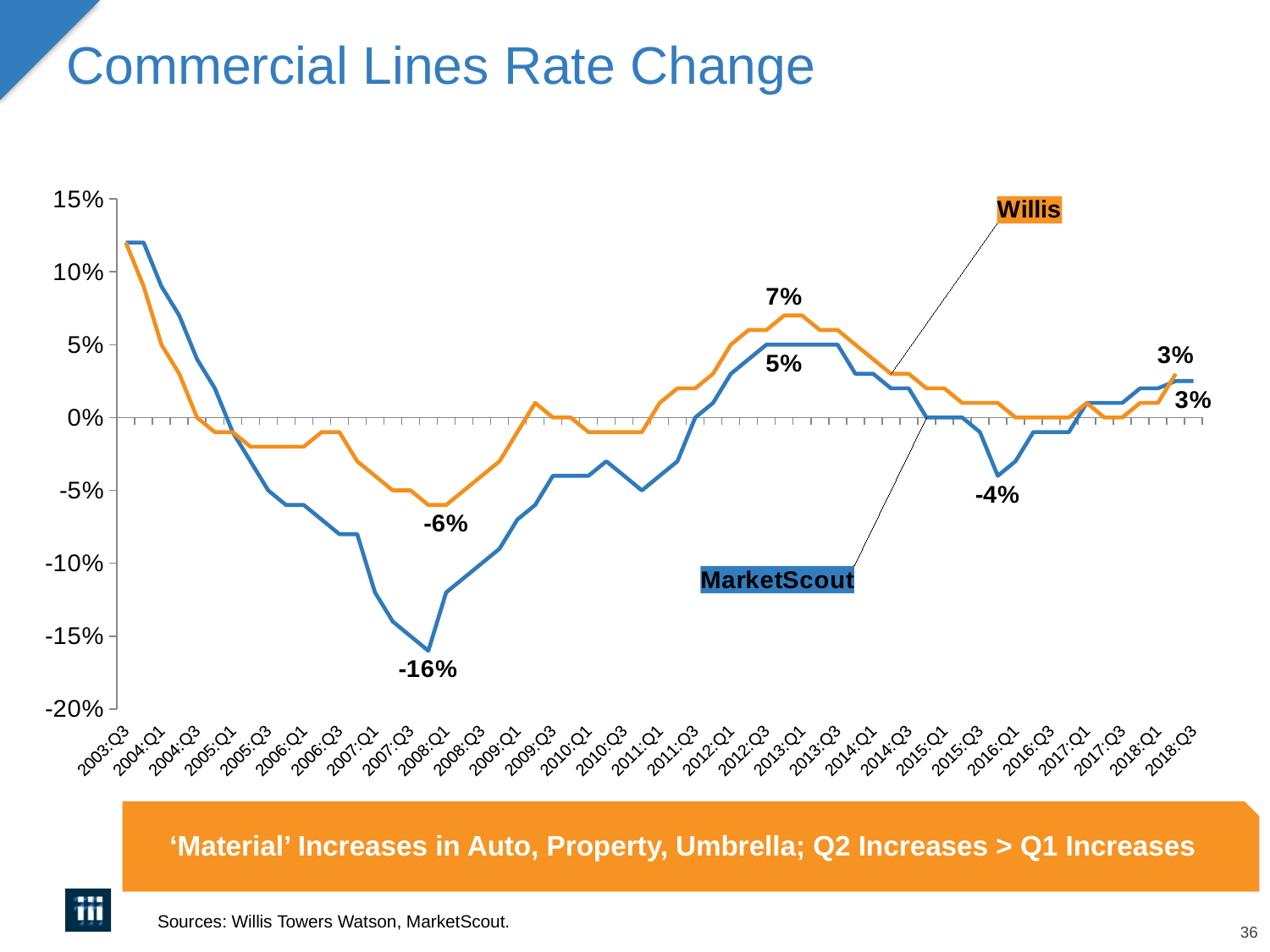
What colour is the Willis line on the chart? orange What is the lowest labelled value of the MarketScout series? -16% Is the value for MarketScout at 2003:Q3 greater or less than 10%? greater What is the difference between the labelled peak of Willis (7%) and the labelled peak of MarketScout (5%)? 2 percentage points What is the highest labelled value of the MarketScout series? 5% What type of chart is shown on the slide? line chart How many data series are plotted on the chart? 2 What is the labelled value of the Willis series at the end of the chart (2018:Q3)? 3% What is the highest labelled value of the Willis series? 7% Which series reached the lower minimum value, Willis or MarketScout? MarketScout What is the lowest labelled value of the Willis series? -6% Does the MarketScout series rise or fall between 2003:Q3 and 2008:Q1? fall